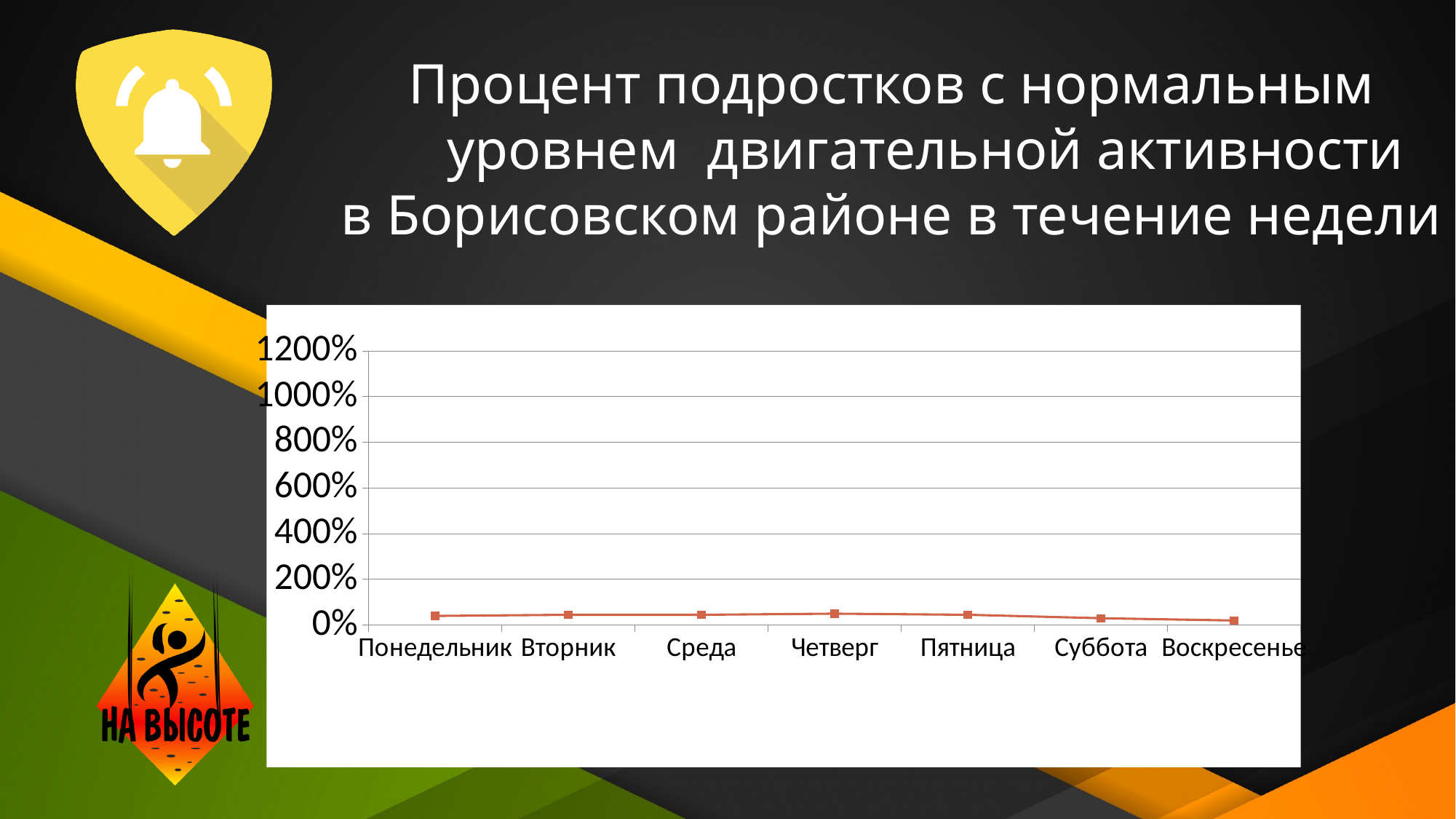
Is the value for Понедельник greater or less than 200%? less How many days (categories) are plotted along the x axis of the chart? 7 Is the value for Суббота greater or less than 600%? less What is the first category on the x axis of the chart? Понедельник What is the highest value shown on the y axis of the chart? 1200% Is the value for Четверг greater or less than 200%? less What kind of chart is shown on the slide? line chart